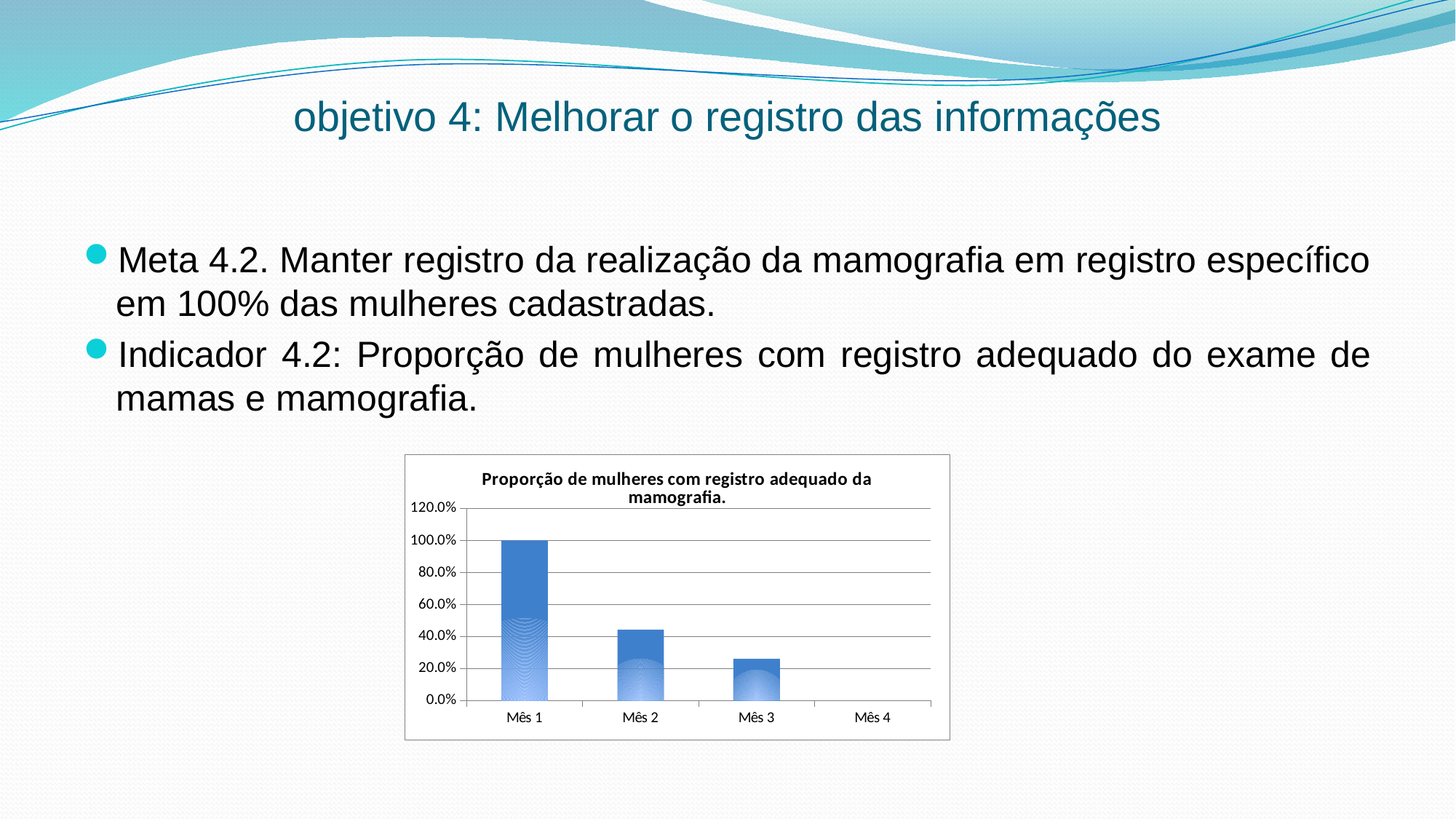
Is the value for Mês 2 greater or less than 40.0%? greater How many categories are shown on the x axis of the chart? 4 Is the value for Mês 3 greater or less than 20.0%? greater What is the title of the chart? Proporção de mulheres com registro adequado da mamografia. Is the value for Mês 2 greater or less than 60.0%? less Do the values rise or fall from Mês 1 to Mês 4? fall Which is larger, the value for Mês 2 or the value for Mês 3? Mês 2 What kind of chart is shown on the slide? bar chart Which month has the lowest value in the chart? Mês 4 Which month has the highest value in the chart? Mês 1 What is the value for Mês 1? 100.0%